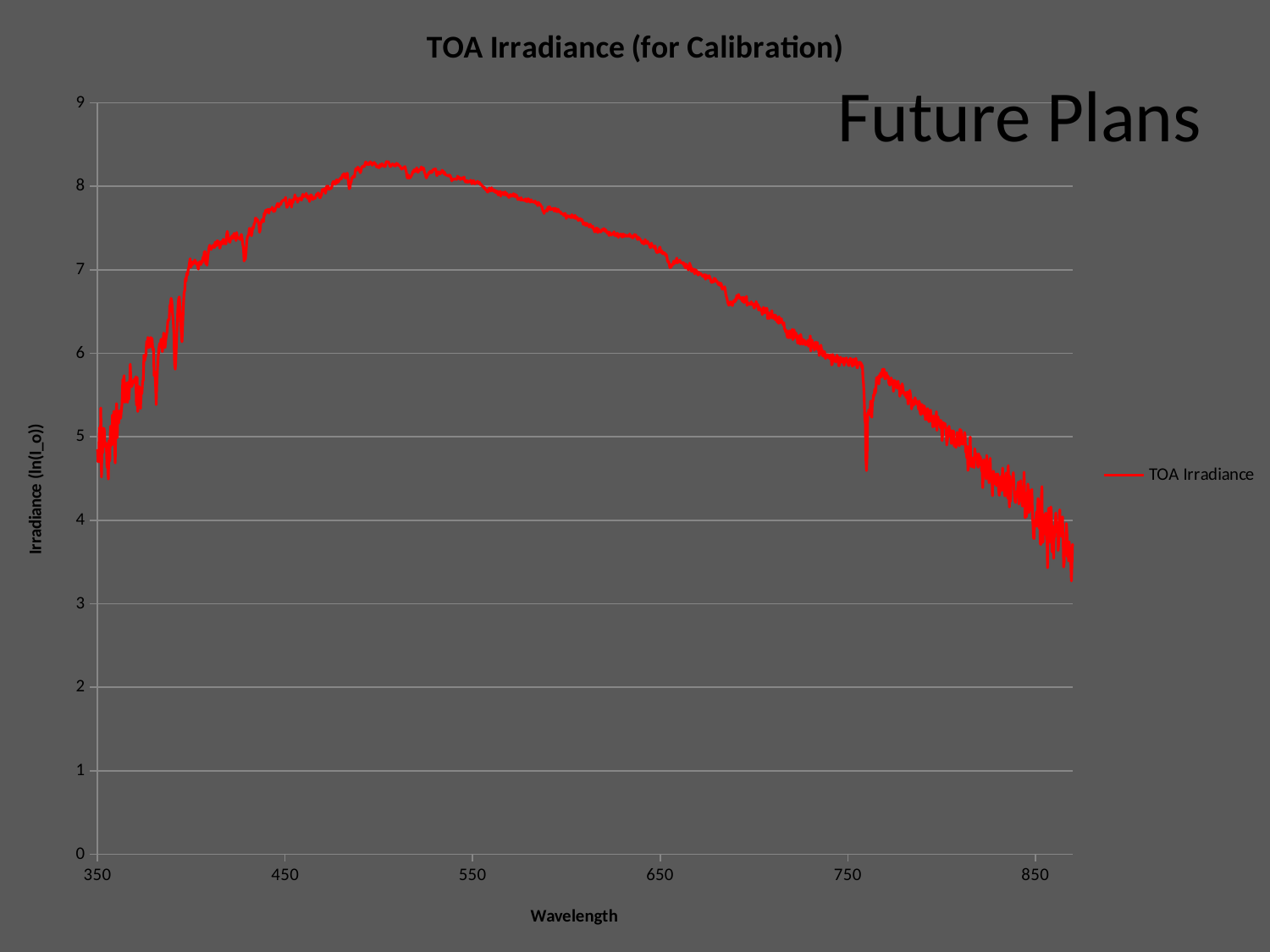
How many series does the legend list? 1 What kind of chart is shown on the slide? line chart Does the TOA Irradiance line rise or fall as wavelength increases from 350 to 450? rise Is the TOA Irradiance value at a wavelength of 750 greater or less than 7? less Is the TOA Irradiance value at a wavelength of 550 greater or less than 7? greater Is the TOA Irradiance value at a wavelength of 350 greater or less than 6? less What is the name of the series shown in the legend? TOA Irradiance Does the TOA Irradiance line rise or fall as wavelength increases from 650 to 850? fall What is the title of the chart? TOA Irradiance (for Calibration) Is the TOA Irradiance value at a wavelength of 550 larger or smaller than the value at 750? larger